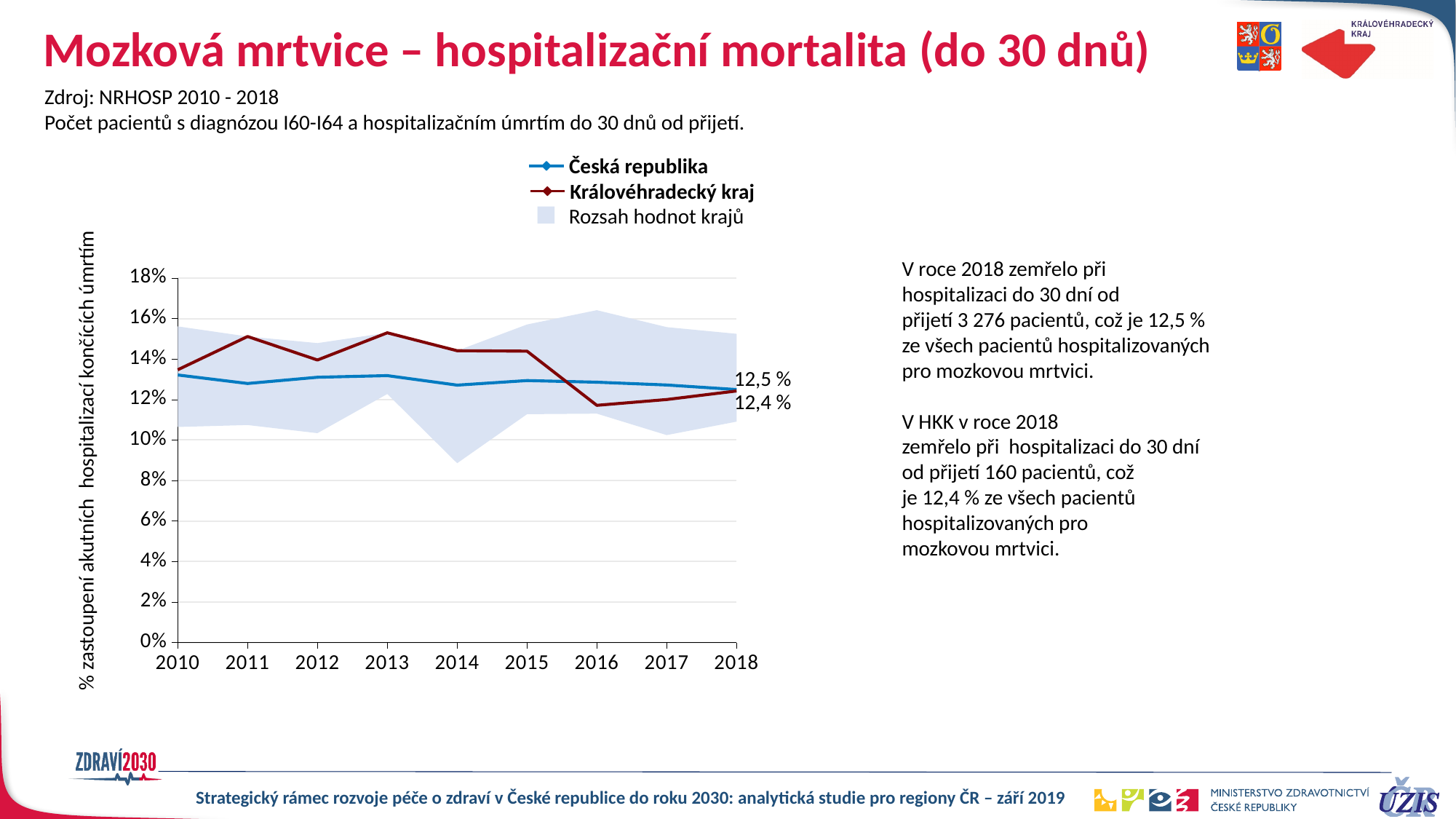
What is the difference between the Česká republika and Královéhradecký kraj values in 2018? 0,1 % Is the value for Česká republika in 2010 greater or less than 12%? greater What is the value for Česká republika in 2018? 12,5 % In which year is the Královéhradecký kraj value lowest? 2016 What kind of chart is shown on the slide? line chart What is the value for Královéhradecký kraj in 2018? 12,4 % Is the value for Královéhradecký kraj in 2016 greater or less than 12%? less How many years are shown on the x axis? 9 In 2018, which series has the higher value: Česká republika or Královéhradecký kraj? Česká republika Is the value for Královéhradecký kraj in 2011 greater or less than 14%? greater Does the Královéhradecký kraj line rise or fall from 2015 to 2016? fall How many entries does the legend list? 3